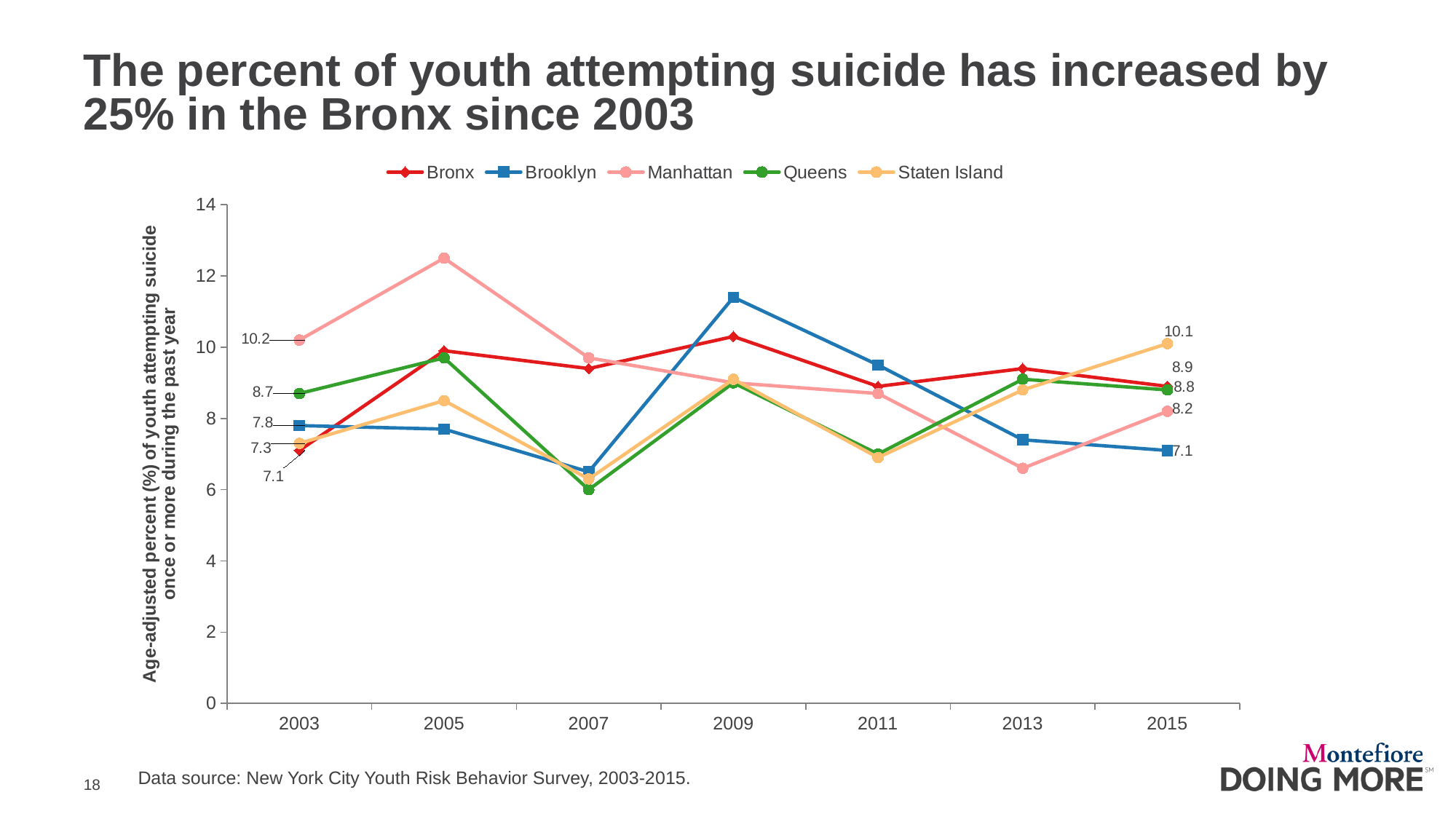
What is the value for Staten Island in 2015? 10.1 What kind of chart is shown on the slide? Line chart By how much did the Bronx value increase from 2003 to 2015? 1.8 Which borough has the lowest value in 2003? Bronx How many years are plotted on the x axis? 7 What is the value for Manhattan in 2003? 10.2 What is the value for the Bronx in 2003? 7.1 In 2015, which is larger: the value for Queens or the value for Brooklyn? Queens Is the value for Manhattan in 2005 greater or less than 12? greater What is the value for the Bronx in 2015? 8.9 How many series does the legend list? 5 Which borough has the highest value in 2015? Staten Island